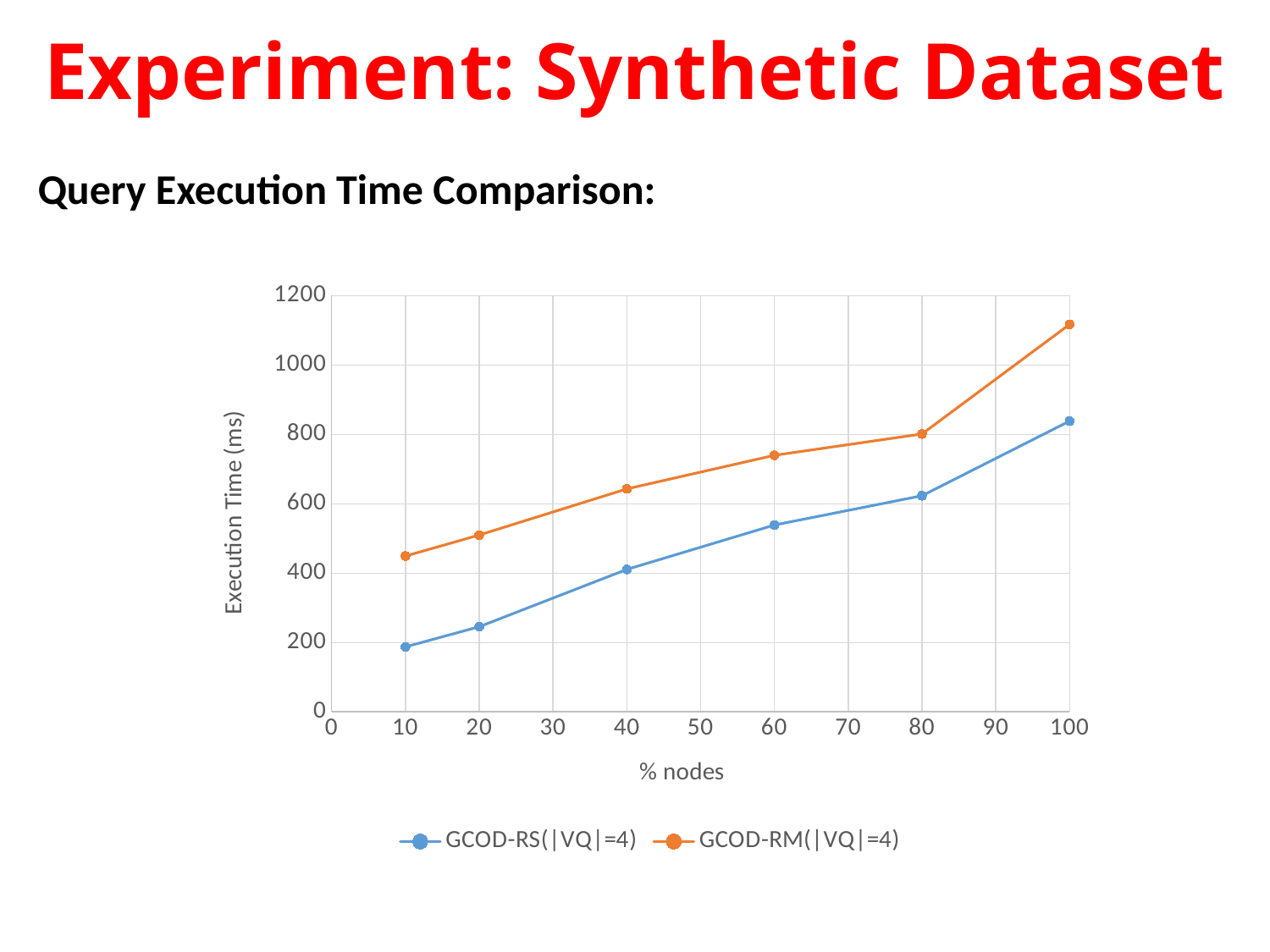
At 100% nodes, which series has the higher execution time, GCOD-RS(|VQ|=4) or GCOD-RM(|VQ|=4)? GCOD-RM(|VQ|=4) How many data points are plotted for the GCOD-RS(|VQ|=4) series? 6 What is the label of the vertical axis? Execution Time (ms) At which % nodes value does GCOD-RS(|VQ|=4) have its lowest execution time? 10 What kind of chart is shown on the slide? line chart Is the execution time for GCOD-RS(|VQ|=4) at 10% nodes greater or less than 200? less Is the execution time for GCOD-RS(|VQ|=4) at 60% nodes greater or less than 600? less Is the execution time for GCOD-RM(|VQ|=4) at 40% nodes greater or less than 600? greater At which % nodes value does GCOD-RM(|VQ|=4) have its highest execution time? 100 Does the execution time for GCOD-RM(|VQ|=4) rise or fall as % nodes increases? rise How many series does the legend list? 2